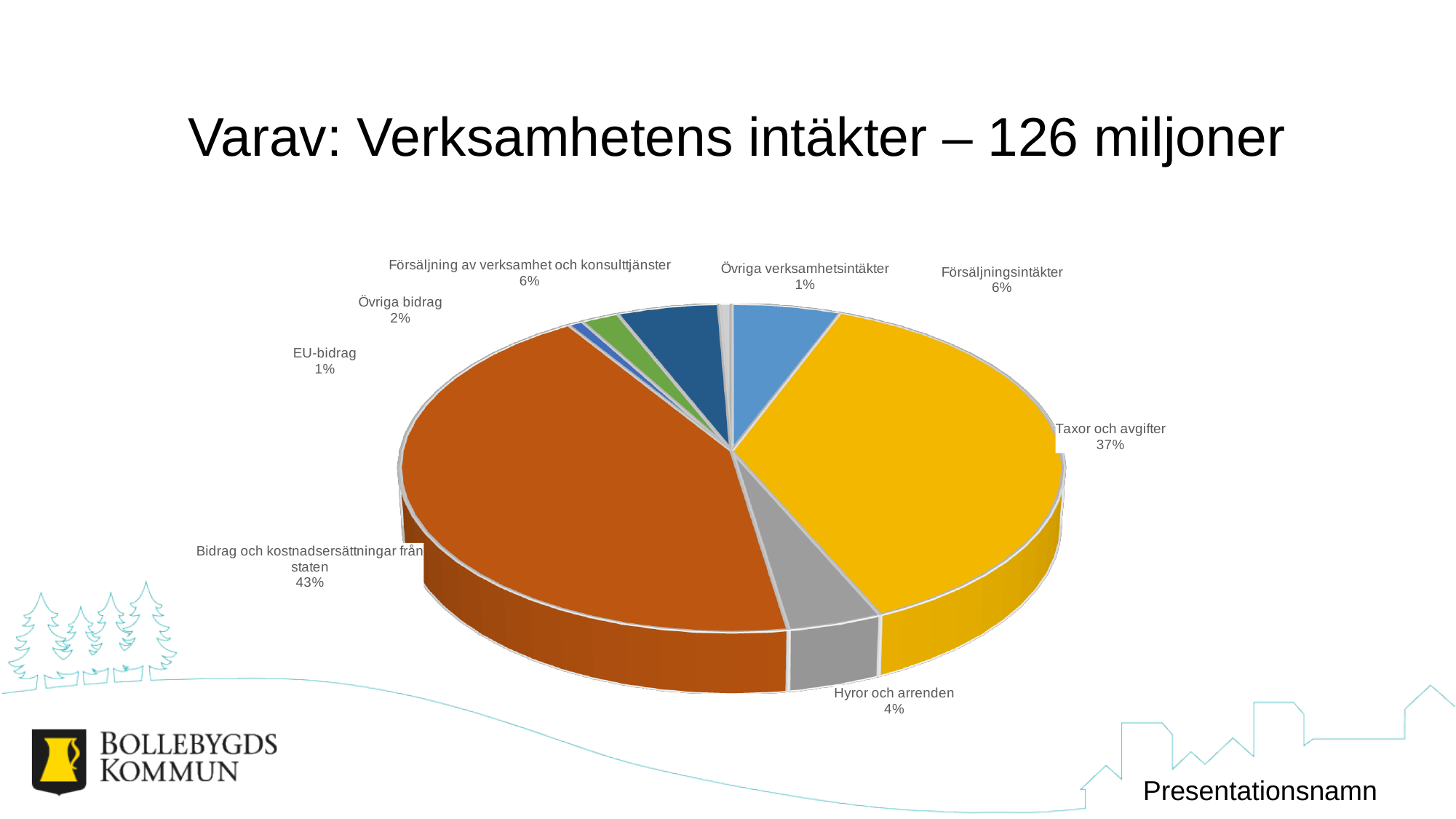
What is the difference in percentage points between Bidrag och kostnadsersättningar från staten and Taxor och avgifter? 6 percentage points What percentage is shown for Hyror och arrenden? 4% What percentage is shown for Övriga bidrag? 2% What percentage is shown for EU-bidrag? 1% How many slices does the pie chart have? 8 What kind of chart is shown on the slide? Pie chart What share of the pie does Taxor och avgifter represent? 37% What share of the pie does Bidrag och kostnadsersättningar från staten represent? 43% What percentage is shown for Försäljning av verksamhet och konsulttjänster? 6% What is the title of the slide containing the pie chart? Varav: Verksamhetens intäkter – 126 miljoner Which is larger, the share for Taxor och avgifter or the share for Hyror och arrenden? Taxor och avgifter Which category has the largest share of the pie? Bidrag och kostnadsersättningar från staten